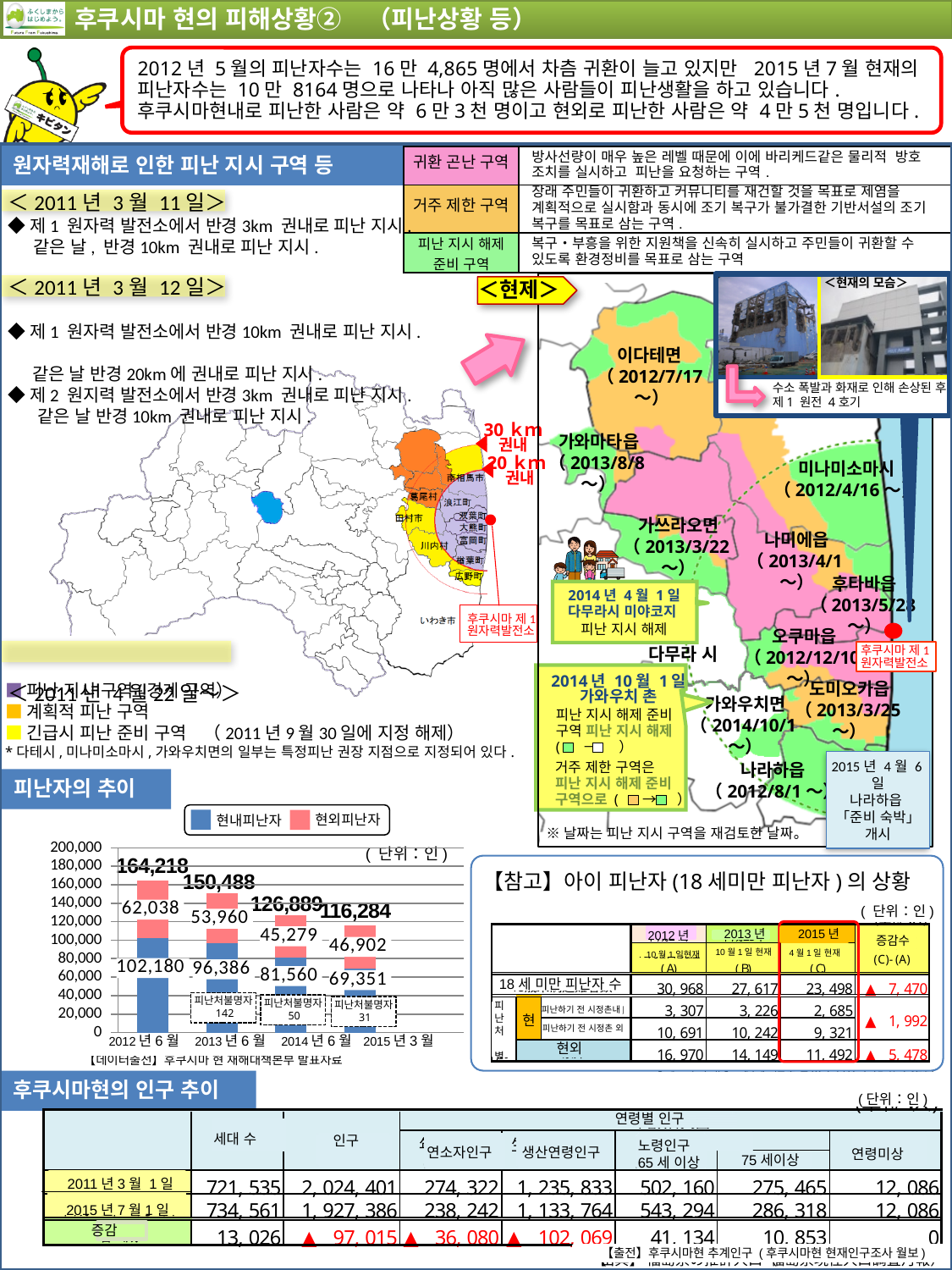
What kind of chart is the 피난자의 추이 chart? Stacked bar chart In the 피난자의 추이 chart, which period has the highest value for 현내피난자? 2012년 6월 In the 피난자의 추이 chart, which is larger: 현내피난자 in 2014년 6월 or 현외피난자 in 2014년 6월? 현내피난자 in 2014년 6월 In the 피난자의 추이 chart, what is the total of the stacked bar for 2014년 6월? 126,889 How many time periods are shown on the x axis of the 피난자의 추이 chart? 4 In the 피난자의 추이 chart, what is the value for 현내피난자 in 2012년 6월? 102,180 In the 피난자의 추이 chart, what is the difference between 현내피난자 in 2012년 6월 and 2015년 3월? 32,829 In the 피난자의 추이 chart, what is the value for 현외피난자 in 2013년 6월? 53,960 In the 피난자의 추이 chart, what is the value for 현외피난자 in 2015년 3월? 46,902 How many series does the legend of the 피난자의 추이 chart list? 2 In the 피난자의 추이 chart, what is the total of the stacked bar for 2012년 6월? 164,218 In the 피난자의 추이 chart, which period has the lowest value for 현외피난자? 2014년 6월